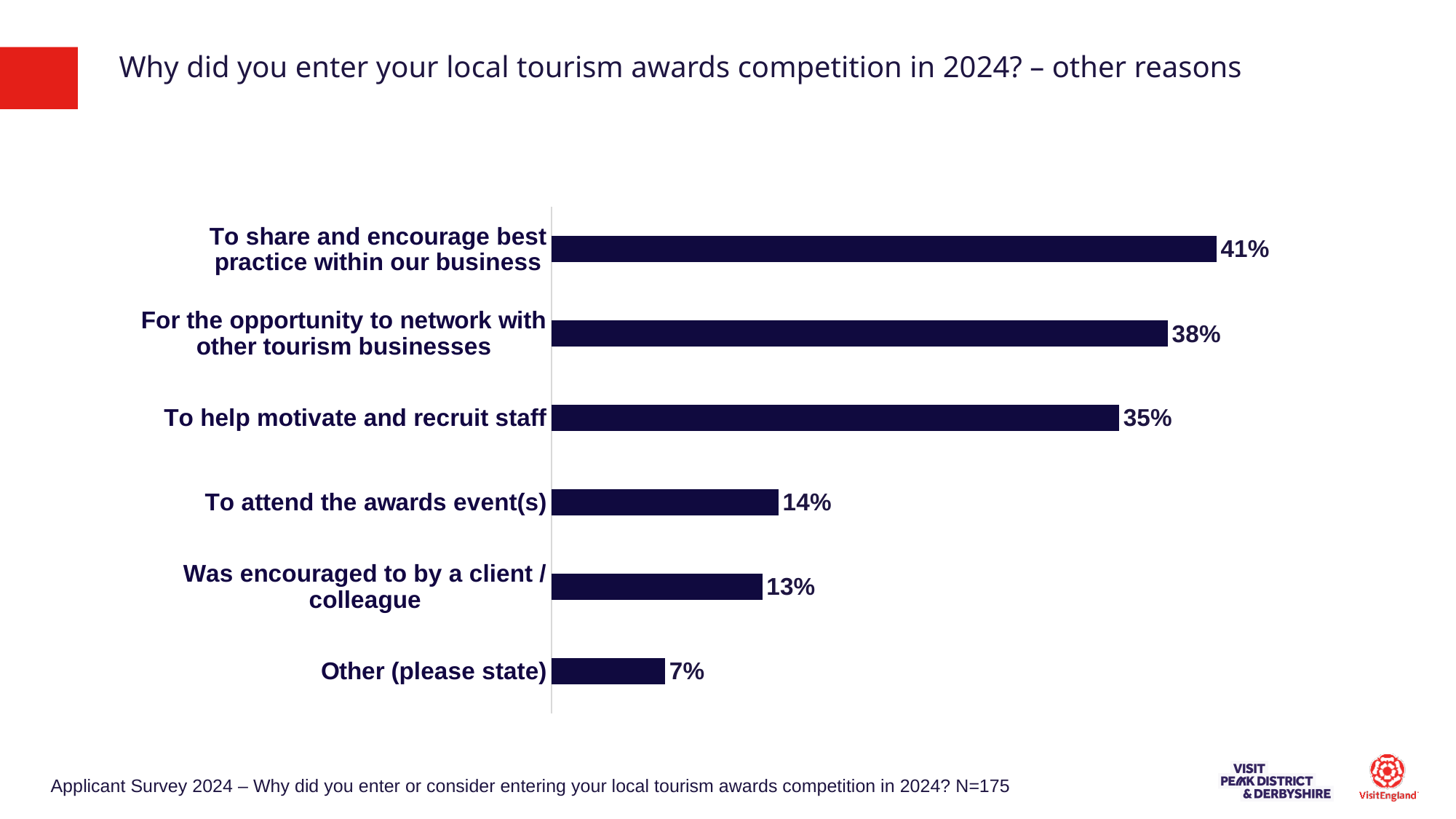
Which is larger: the value for 'To attend the awards event(s)' or 'Was encouraged to by a client / colleague'? To attend the awards event(s) What is the difference in percentage points between 'To share and encourage best practice within our business' and 'To help motivate and recruit staff'? 6 What kind of chart is shown on the slide? Bar chart What percentage entered to help motivate and recruit staff? 35% Which reason has the highest percentage? To share and encourage best practice within our business What is the value for 'Was encouraged to by a client / colleague'? 13% Which reason has the lowest percentage? Other (please state) What is the sample size (N) stated in the source note at the bottom of the slide? 175 What is the value for 'For the opportunity to network with other tourism businesses'? 38% What percentage of respondents entered to share and encourage best practice within their business? 41% How many reasons are shown in the chart? 6 What is the difference in percentage points between 'To attend the awards event(s)' and 'Other (please state)'? 7